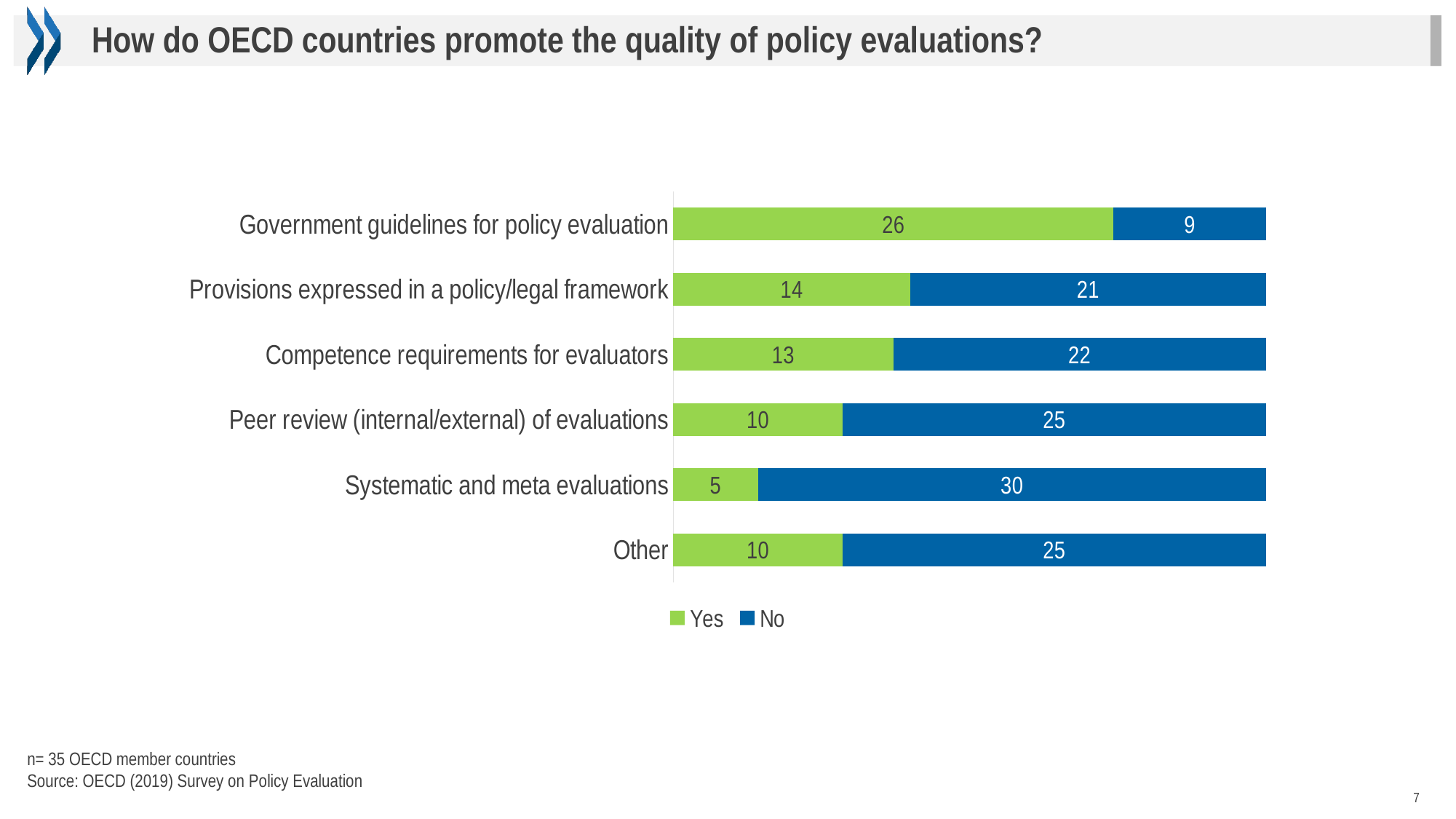
How many series does the legend list? 2 What is the difference between the 'No' and 'Yes' values for Provisions expressed in a policy/legal framework? 7 Which category has the highest 'Yes' value? Government guidelines for policy evaluation What is the 'Yes' value for Competence requirements for evaluators? 13 What is the total of the stacked bar for Competence requirements for evaluators? 35 Which is larger for Peer review (internal/external) of evaluations: the 'Yes' value or the 'No' value? No What is the 'Yes' value for Government guidelines for policy evaluation? 26 Which colour represents the 'Yes' series in the chart? Green How many categories are shown in the chart? 6 Which category has the lowest 'Yes' value? Systematic and meta evaluations What kind of chart is shown on the slide? Stacked bar chart What is the 'No' value for Systematic and meta evaluations? 30